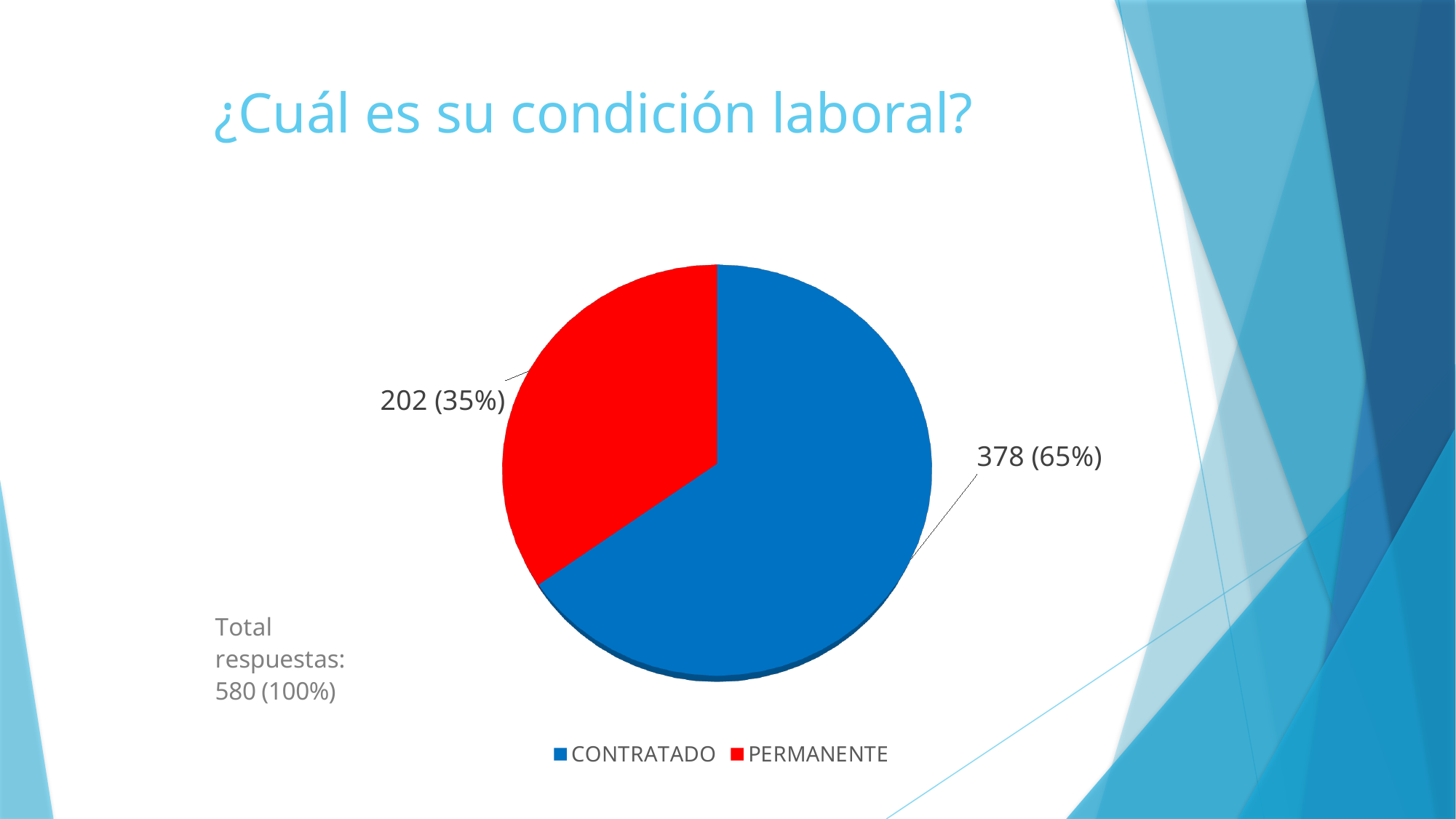
What colour is the CONTRATADO slice? blue How many entries does the legend list? 2 What is the total number of responses shown on the slide? 580 (100%) What is the difference in count between CONTRATADO and PERMANENTE? 176 What is the value shown for PERMANENTE? 202 (35%) Which category has the smallest slice of the pie? PERMANENTE What share of the pie does PERMANENTE represent? 35% What is the value shown for CONTRATADO? 378 (65%) How many slices does the pie chart have? 2 Which category has the largest slice of the pie? CONTRATADO Which is larger, CONTRATADO or PERMANENTE? CONTRATADO What kind of chart is shown on the slide? pie chart